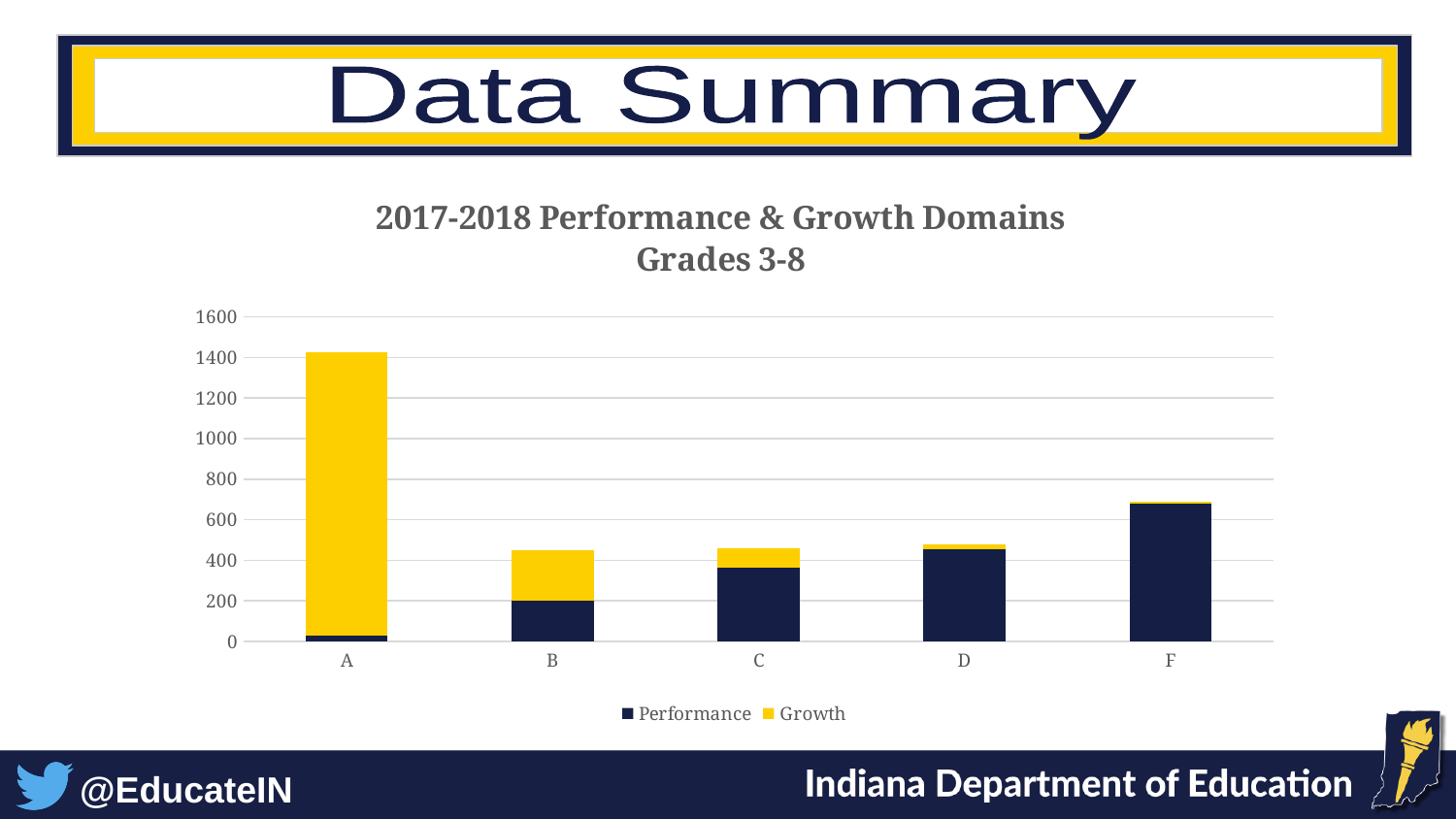
Which is larger, the Performance value for F or the Performance value for D? F How many categories are shown on the x axis of the chart? 5 What kind of chart is shown on the slide? Stacked bar chart Which category has the smallest Performance value? A Which category has the tallest stacked bar overall? A What is the title of the chart? 2017-2018 Performance & Growth Domains Grades 3-8 Is the total stacked value for A greater or less than 1200? greater How many series does the chart's legend list? 2 Is the Performance value for B greater or less than 400? less Which category has the largest Growth value? A Which is larger, the Growth value for B or the Growth value for C? B Is the Performance value for F greater or less than 600? greater